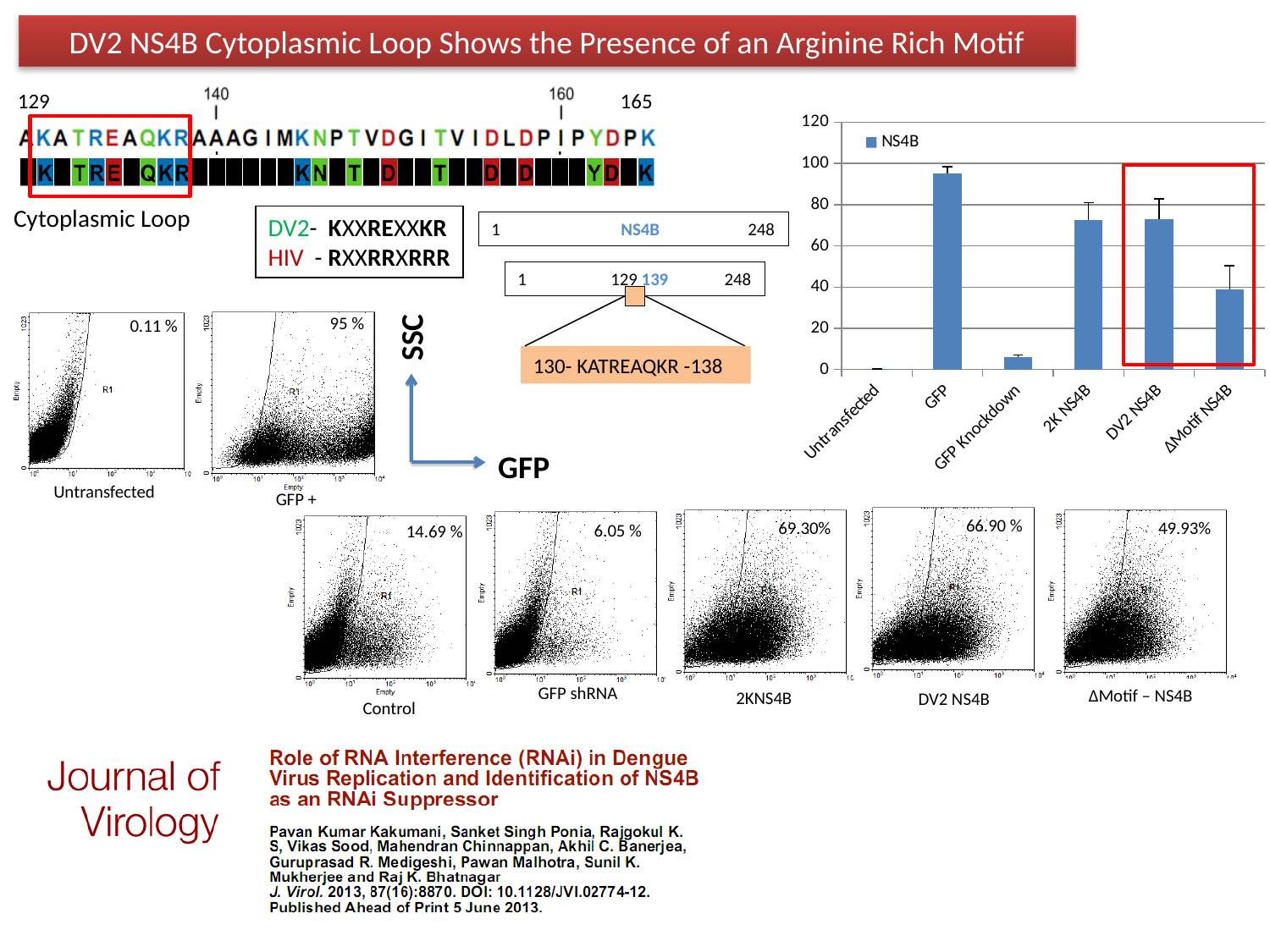
In the bar chart, which is larger, the value for GFP or the value for ΔMotif NS4B? GFP How many categories are shown on the x axis of the bar chart? 6 What kind of chart is shown on the right side of the slide? bar chart What is the name of the series in the bar chart's legend? NS4B Which category has the lowest bar in the bar chart? Untransfected In the bar chart, is the value for ΔMotif NS4B greater or less than 60? less In the bar chart, which is larger, the value for GFP Knockdown or the value for ΔMotif NS4B? ΔMotif NS4B Which category has the highest bar in the bar chart? GFP In the bar chart, is the value for 2K NS4B greater or less than 60? greater How many series does the legend of the bar chart list? 1 In the bar chart, is the value for GFP Knockdown greater or less than 20? less